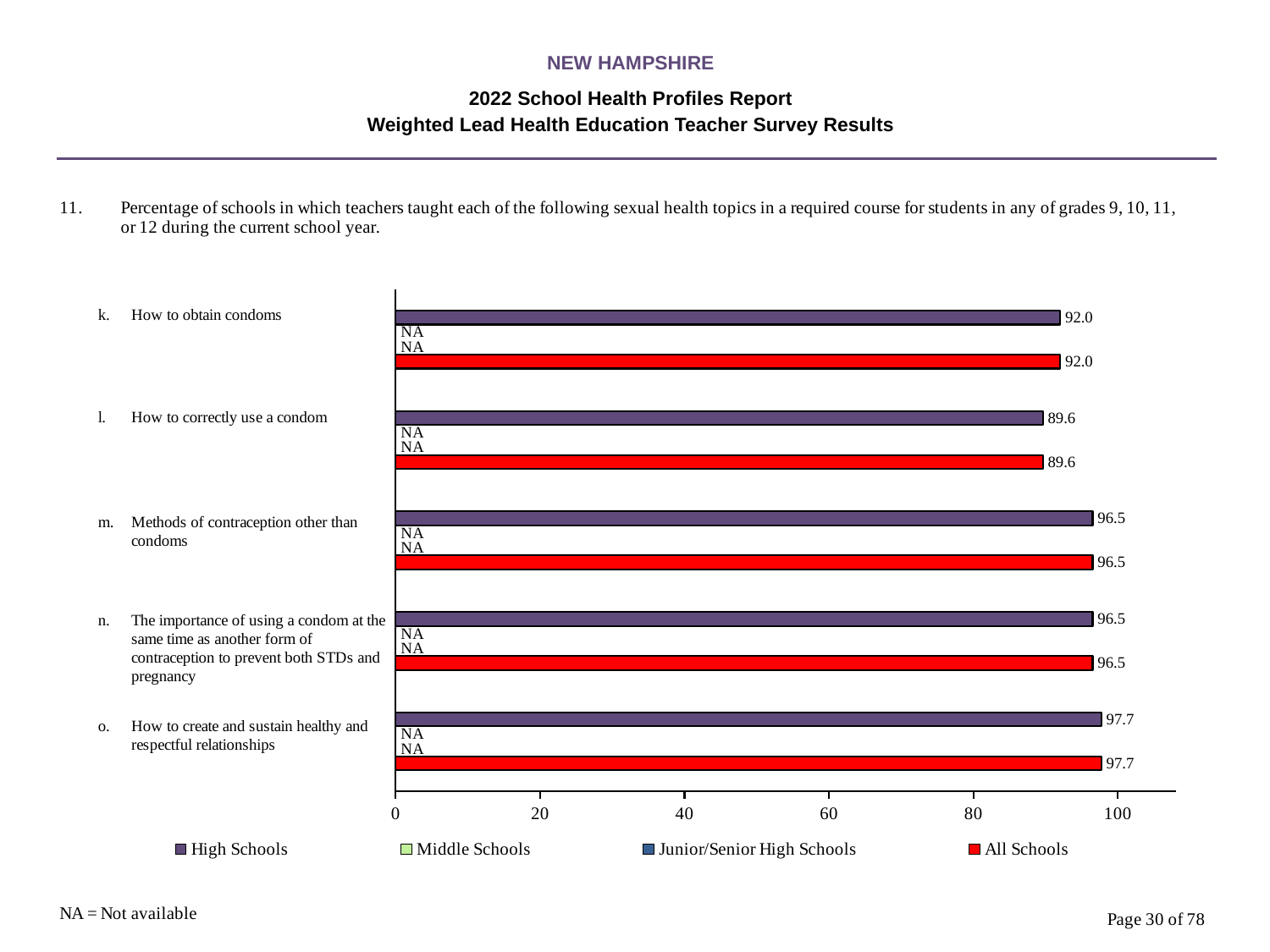
What is the All Schools value for 'Methods of contraception other than condoms'? 96.5 Is the All Schools value for 'How to correctly use a condom' greater or less than 80? greater What is the All Schools value for 'How to correctly use a condom'? 89.6 How many topics are shown in the chart? 5 What is the High Schools value for 'How to create and sustain healthy and respectful relationships'? 97.7 Which topic has the highest High Schools value? How to create and sustain healthy and respectful relationships What type of chart is shown on the slide? bar chart Which is larger for High Schools: 'How to obtain condoms' or 'Methods of contraception other than condoms'? Methods of contraception other than condoms What is the High Schools value for 'How to obtain condoms'? 92.0 Which topic has the lowest All Schools value? How to correctly use a condom How many series does the legend list? 4 What is the difference between the High Schools values for 'How to obtain condoms' and 'How to correctly use a condom'? 2.4